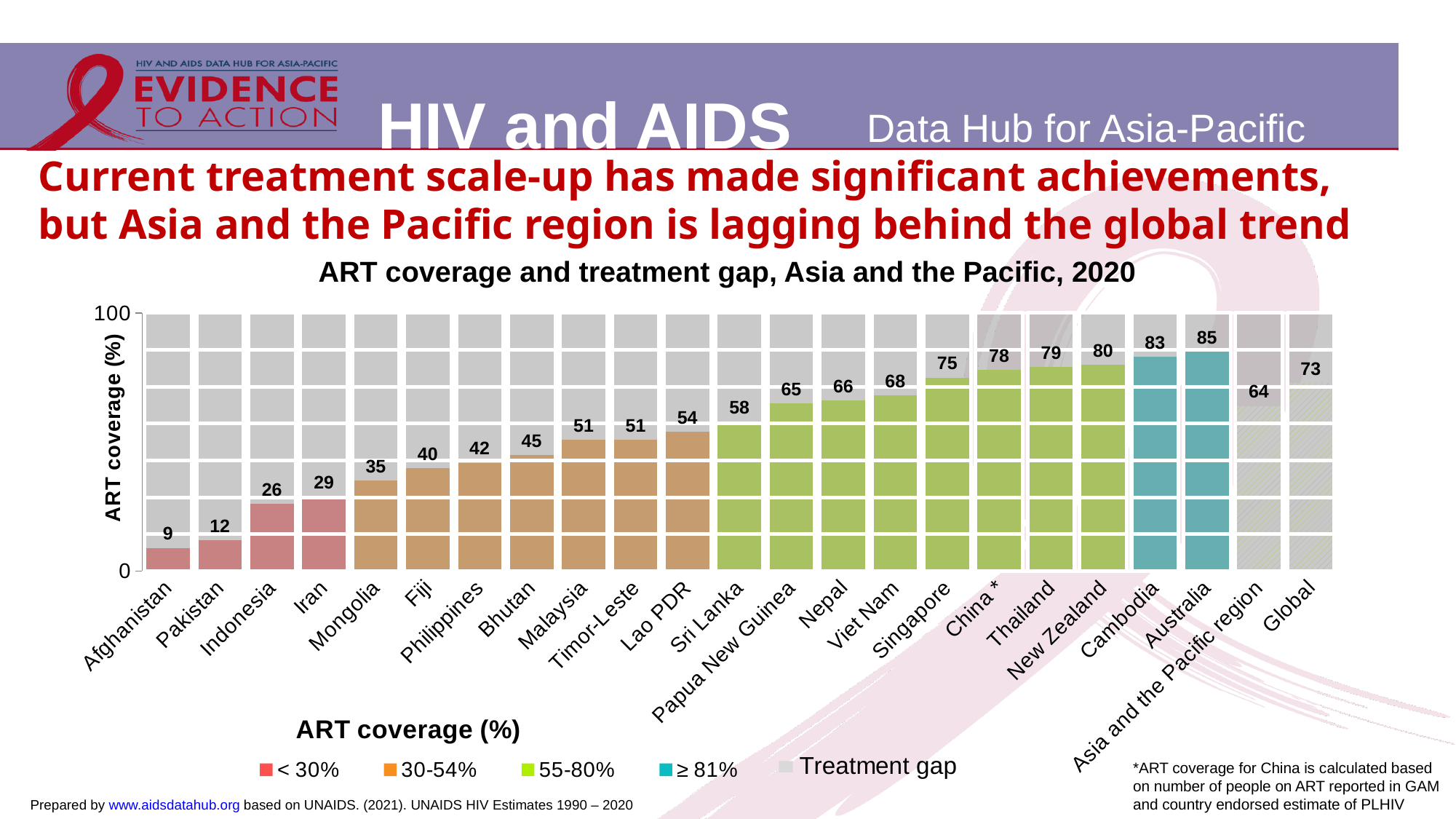
What kind of chart is shown on the slide? Bar chart Which has a higher ART coverage value, Thailand or Singapore? Thailand How many entries does the chart's legend list? 5 What is the ART coverage value shown for Afghanistan? 9 Do the ART coverage values for the countries from Afghanistan to Australia rise or fall along the x axis? Rise What is the title of the chart on the slide? ART coverage and treatment gap, Asia and the Pacific, 2020 Which country has the lowest ART coverage value on the chart? Afghanistan What is the ART coverage value shown for the Asia and the Pacific region? 64 How many categories (countries and regions) are shown on the x axis of the chart? 23 Which country has the highest ART coverage value on the chart? Australia What is the difference between the Global ART coverage value and the Asia and the Pacific region value? 9 What is the ART coverage value shown for Viet Nam? 68